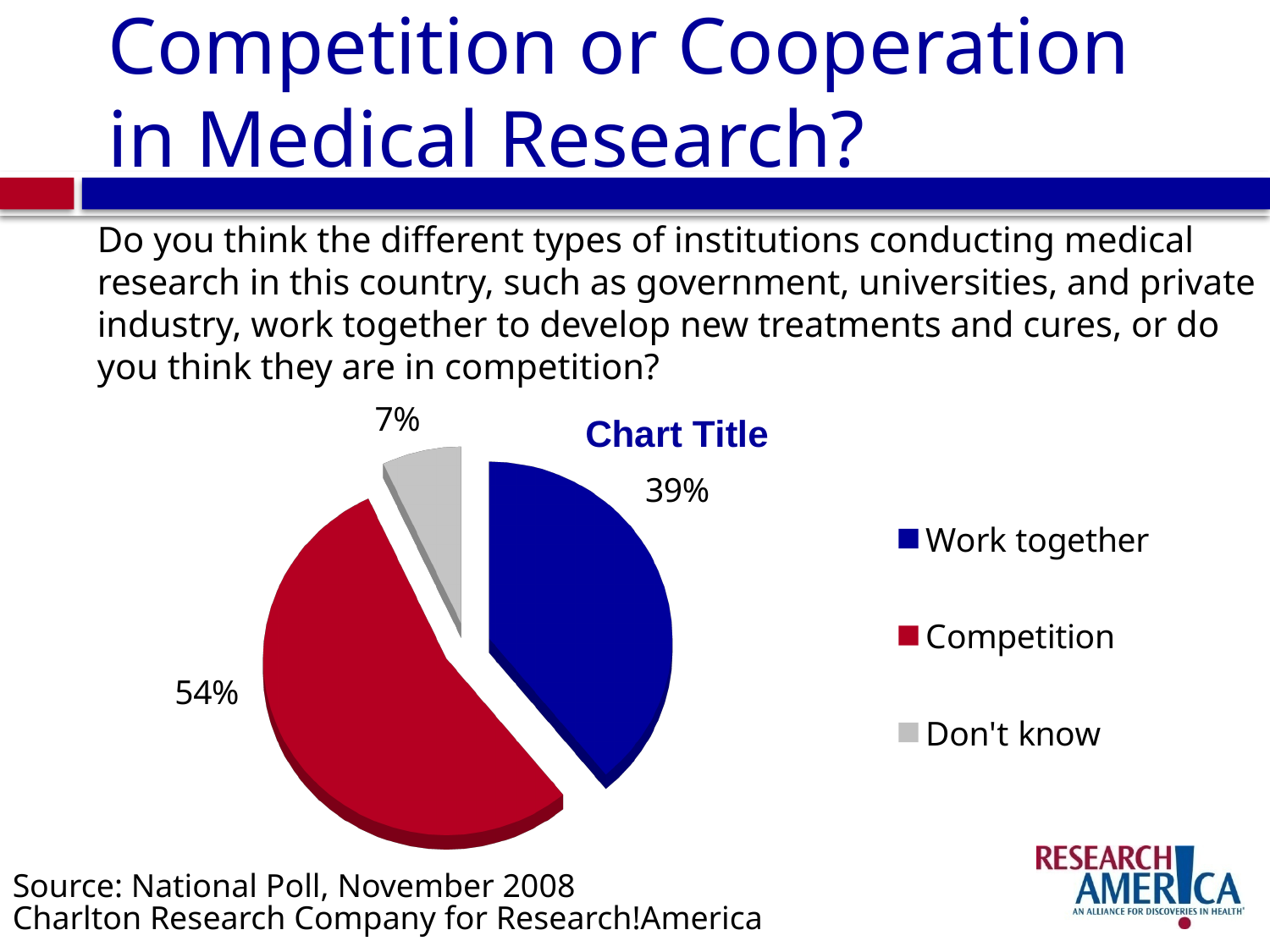
What percentage of respondents answered "Don't know"? 7% How many entries does the legend list? 3 How many slices does the pie chart have? 3 Which response has the largest share of the pie? Competition What is the difference in percentage points between "Competition" and "Work together"? 15 What percentage of respondents said the institutions are in competition? 54% What colour is the "Work together" slice? blue Which is larger, the share for "Work together" or the share for "Competition"? Competition What kind of chart is shown on the slide? pie chart What title is printed on the chart? Chart Title What percentage of respondents said the institutions work together? 39% Which response has the smallest share of the pie? Don't know